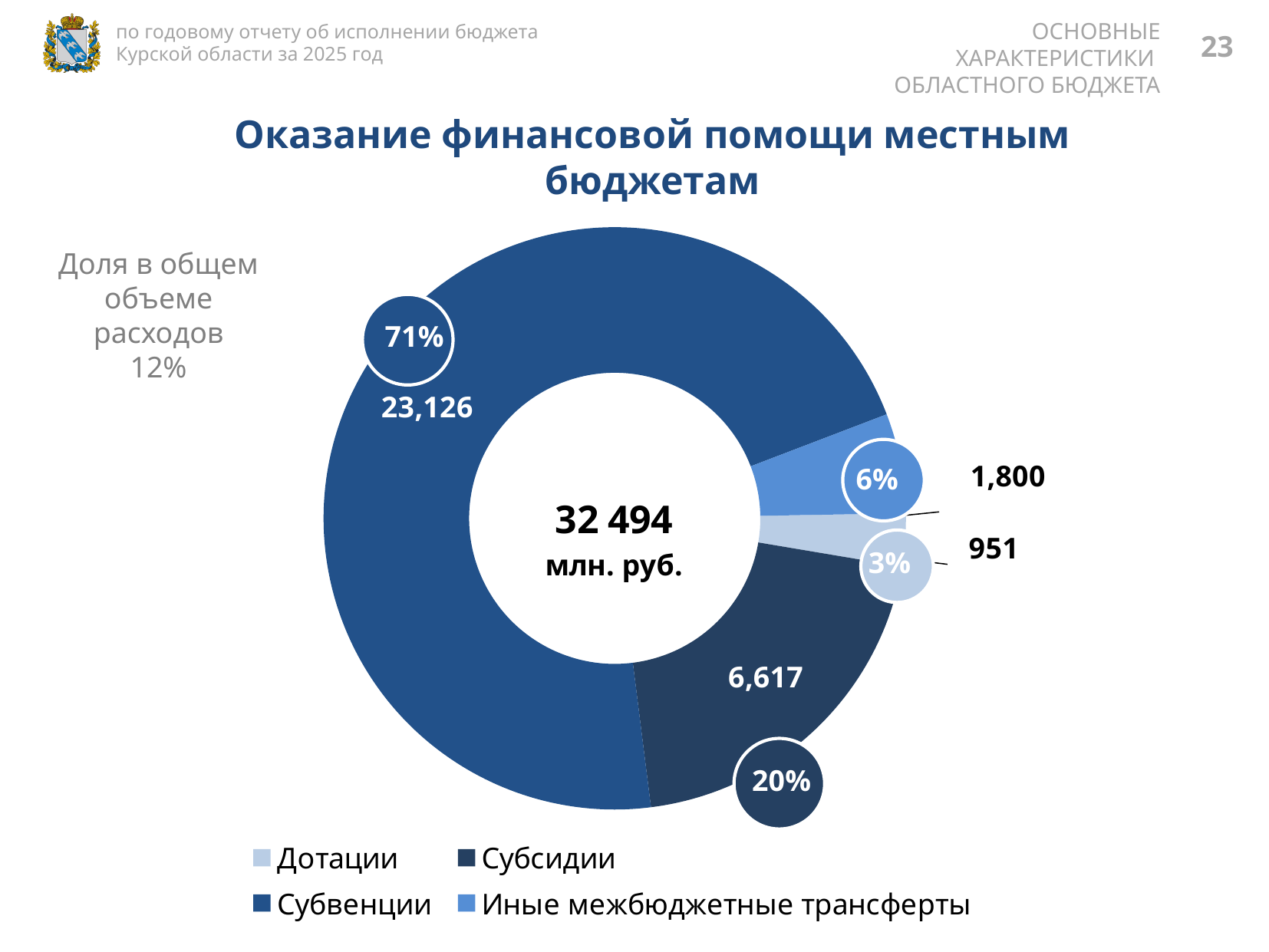
What share of the chart does Субвенции represent? 71% What is the value shown for Субвенции? 23,126 What is the value shown for Субсидии? 6,617 Which category has the smallest slice in the chart? Дотации What total value is shown in the centre of the donut chart? 32 494 млн. руб. What share of the chart does Дотации represent? 3% What is the value shown for Иные межбюджетные трансферты? 1,800 What type of chart is shown on the slide? Pie chart (donut) Which is larger, the value for Субсидии or the value for Иные межбюджетные трансферты? Субсидии Which category has the largest slice in the chart? Субвенции How many categories does the legend of the chart list? 4 What is the value shown for Дотации? 951